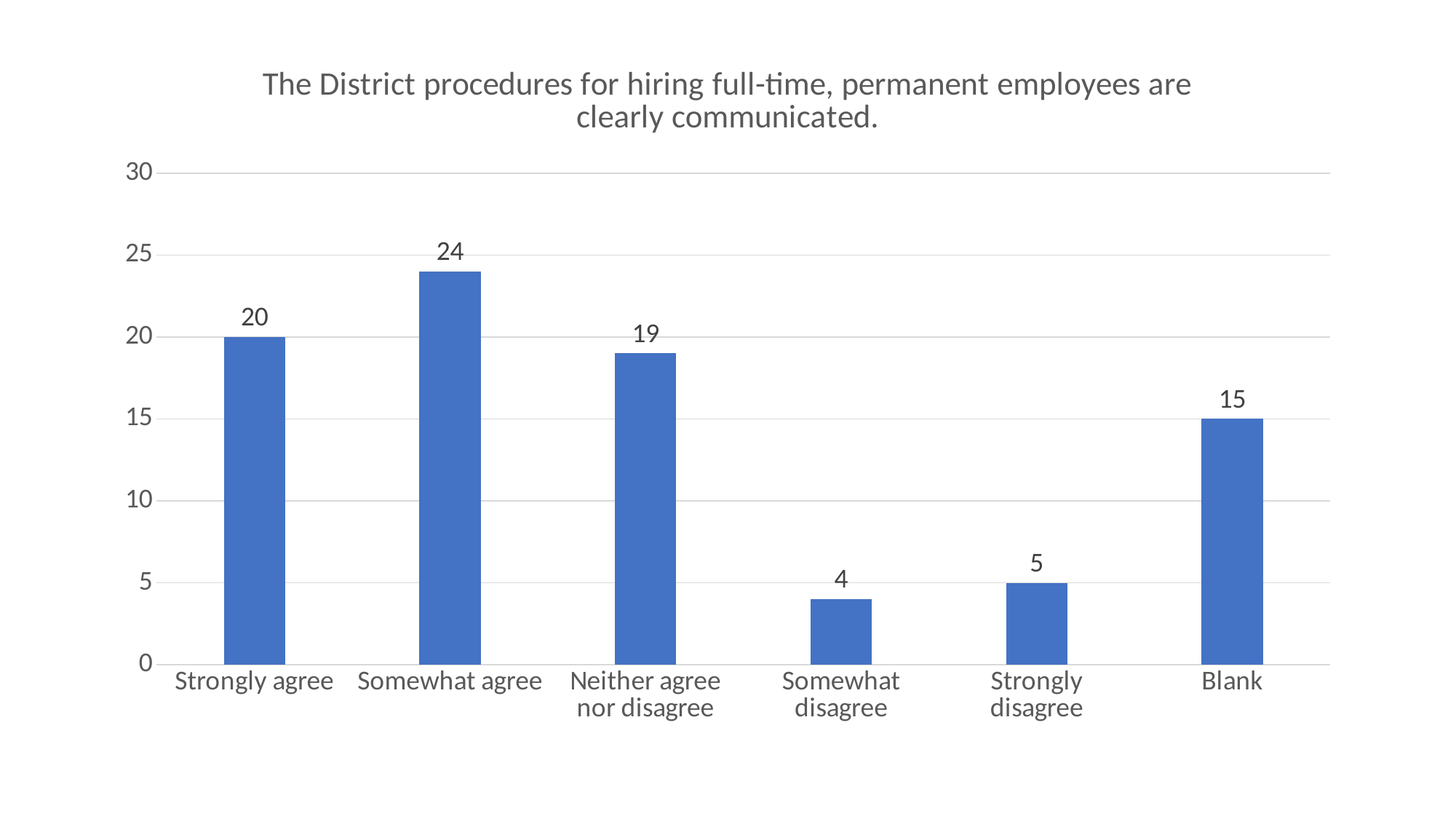
Which category has the highest value? Somewhat agree What is the value for Somewhat agree? 24 What is the value for Blank? 15 What is the title of the chart? The District procedures for hiring full-time, permanent employees are clearly communicated. Is the value for Blank greater or less than 10? greater What is the value for Strongly disagree? 5 What is the difference between the values for Somewhat agree and Strongly agree? 4 Which is larger, the value for Strongly agree or the value for Neither agree nor disagree? Strongly agree What is the difference between the values for Neither agree nor disagree and Somewhat disagree? 15 How many categories are shown on the x axis? 6 Which category has the lowest value? Somewhat disagree What kind of chart is shown on the slide? bar chart